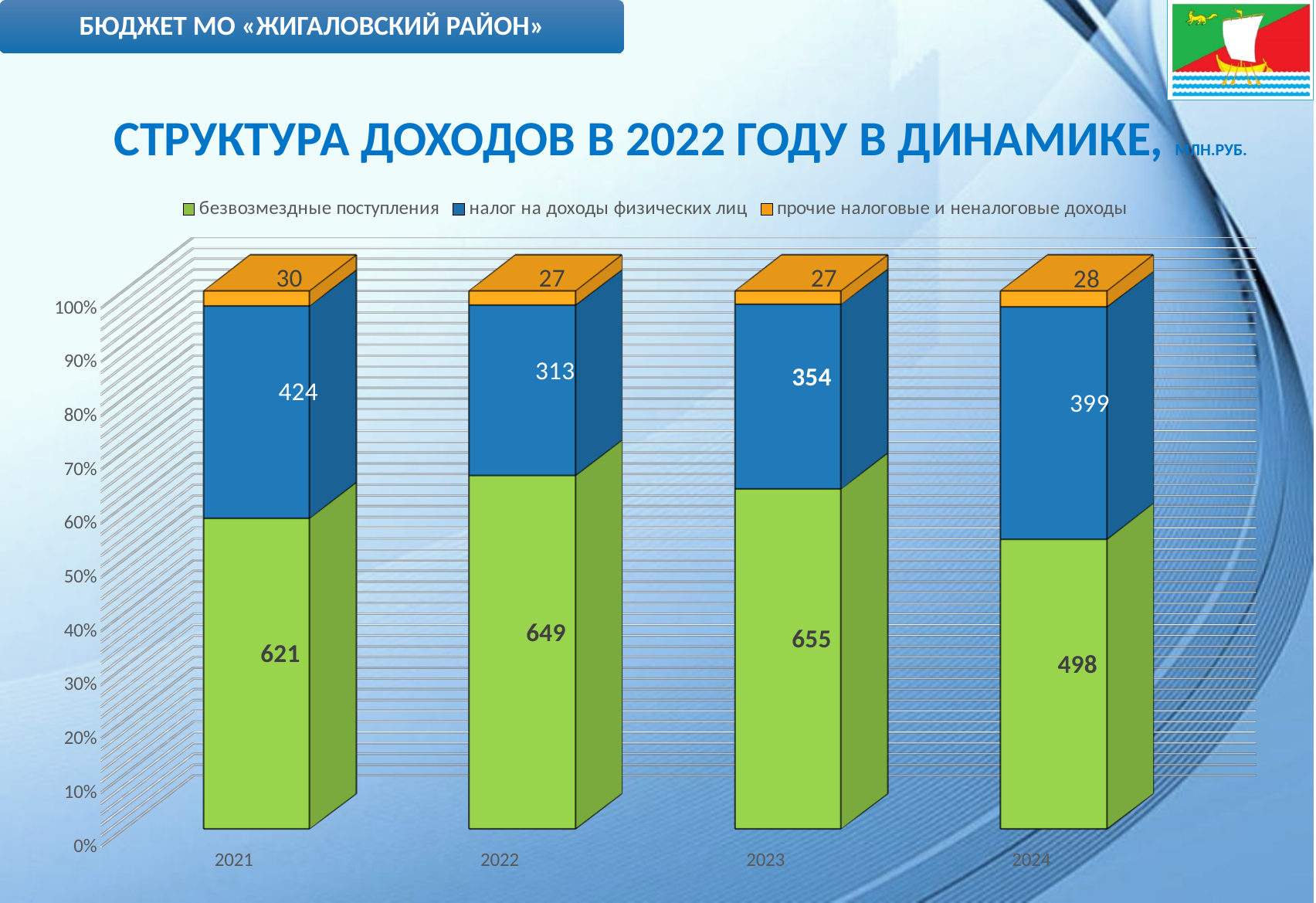
What is the value for прочие налоговые и неналоговые доходы in 2022? 27 What kind of chart is shown on the slide? Stacked bar chart Which is larger: налог на доходы физических лиц in 2021 or in 2023? 2021 In which year is the value for налог на доходы физических лиц the lowest? 2022 In which year is the value for безвозмездные поступления the highest? 2023 What is the value for безвозмездные поступления in 2021? 621 What is the difference between the безвозмездные поступления values for 2023 and 2024? 157 What is the value for налог на доходы физических лиц in 2024? 399 How many series does the legend list? 3 Which colour represents прочие налоговые и неналоговые доходы in the chart? Orange What is the total of the stacked bar for 2022? 989 How many years are shown on the x axis? 4